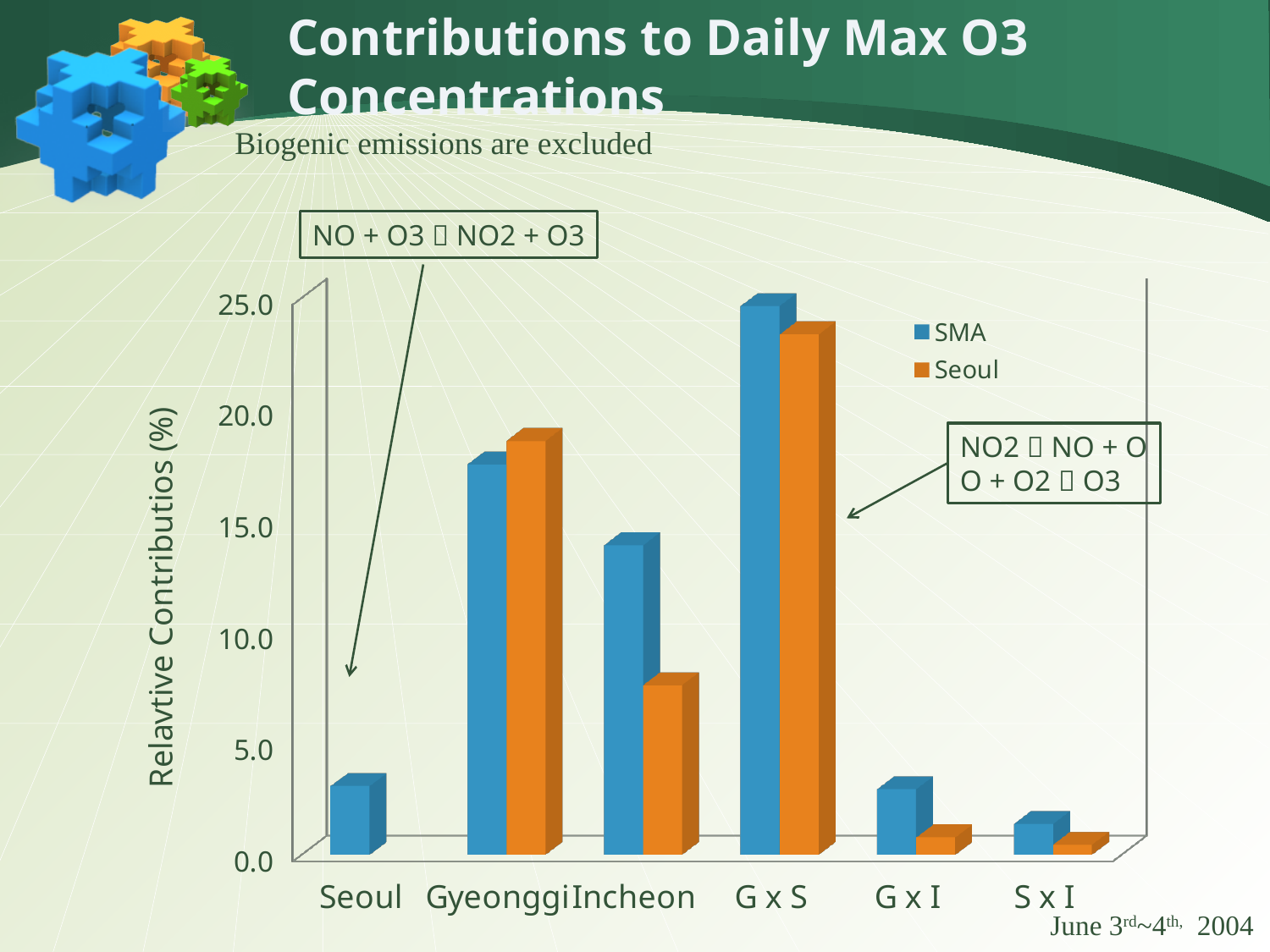
What is the label of the y axis? Relavtive Contributios (%) Is the Seoul value for Incheon greater or less than 10.0? less What kind of chart is shown on the slide? bar chart Is the SMA value for Seoul greater or less than 5.0? less Is the SMA value for Incheon greater or less than 10.0? greater Which category has the highest SMA value? G x S How many series does the legend list? 2 For Incheon, which series has the larger value, SMA or Seoul? SMA Which category has the highest Seoul value? G x S How many categories are shown along the x axis? 6 For Gyeonggi, which series has the larger value, SMA or Seoul? Seoul